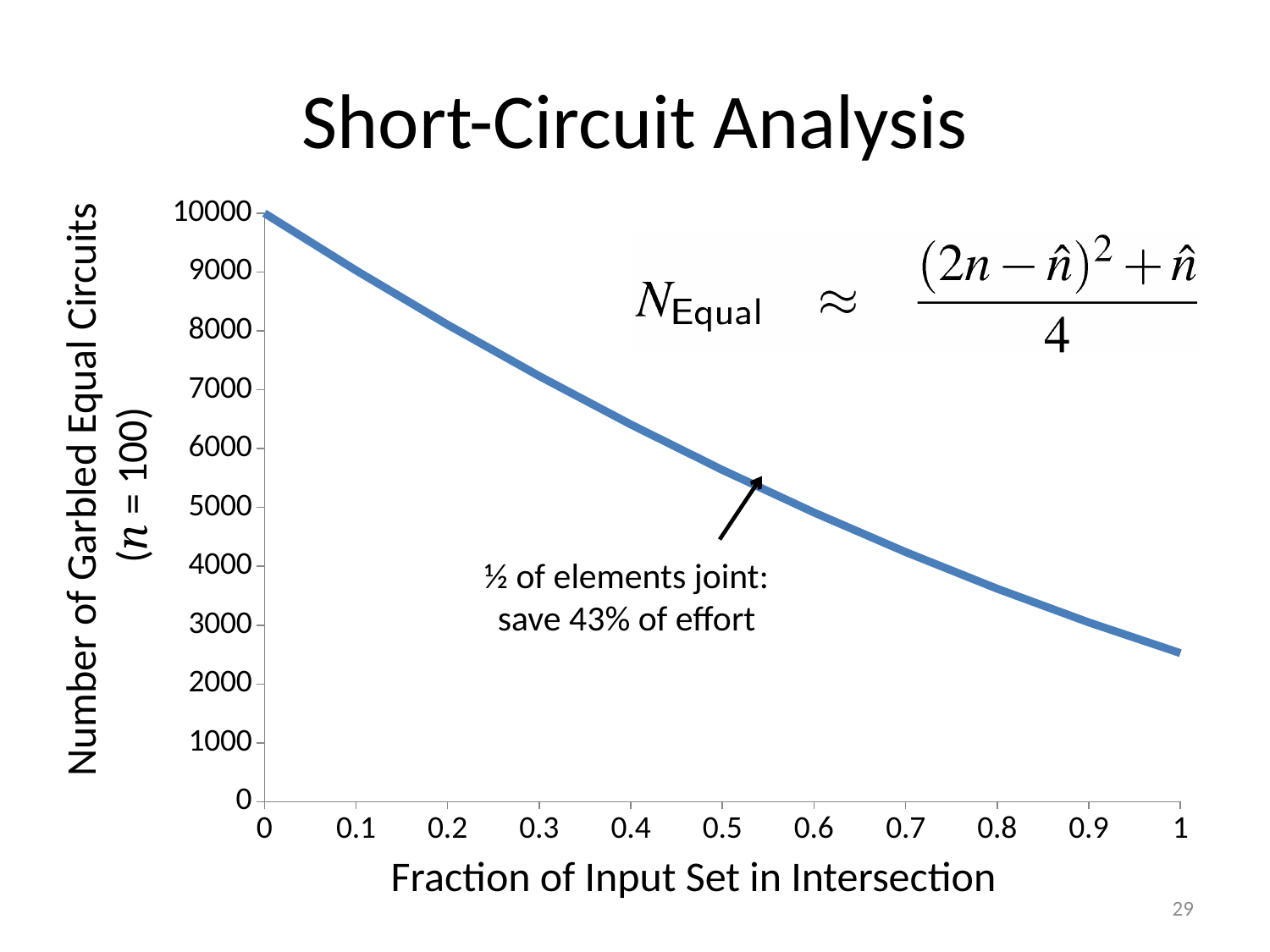
Is the number of garbled equal circuits at a fraction of 0.4 greater or less than 6000? greater Is the number of garbled equal circuits at a fraction of 0.8 greater or less than 4000? less According to the annotation on the chart, how much effort is saved when half of the elements are joint? 43% Do the values rise or fall as the fraction of input set in intersection increases from 0 to 1? fall At which fraction of input set in intersection is the number of garbled equal circuits lowest? 1 What is the title of the x axis? Fraction of Input Set in Intersection What kind of chart is shown on the slide? line chart Which has a larger number of garbled equal circuits: a fraction of 0.2 or a fraction of 0.8? 0.2 Is the number of garbled equal circuits at a fraction of 0.5 greater or less than 5000? greater What is the number of garbled equal circuits when the fraction of input set in intersection is 0? 10000 At which fraction of input set in intersection is the number of garbled equal circuits highest? 0